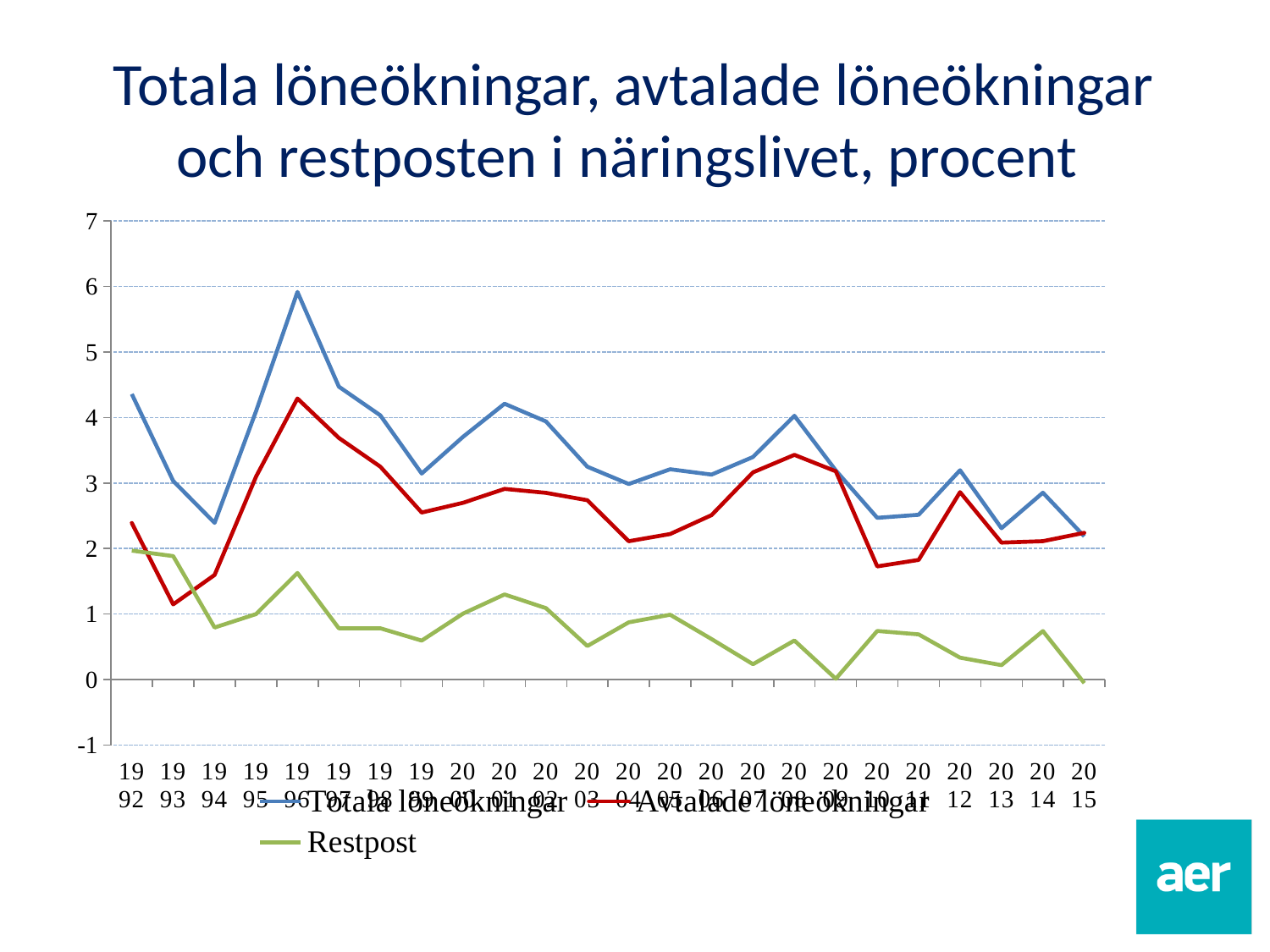
Which series has the higher value in 1996, Totala löneökningar or Avtalade löneökningar? Totala löneökningar Is the value for Totala löneökningar in 1994 greater or less than 3? less How many years are plotted along the x axis? 24 In which year does the Avtalade löneökningar series reach its lowest value? 1993 How many series does the legend list? 3 What kind of chart is shown on the slide? line chart In which year does the Totala löneökningar series reach its highest value? 1996 In which year does the Avtalade löneökningar series reach its highest value? 1996 Is the value for Avtalade löneökningar in 1993 greater or less than 2? less Does the Totala löneökningar series rise or fall from 1992 to 1994? fall Which colour is used for the Restpost series? green Is the value for Totala löneökningar in 1996 greater or less than 5? greater